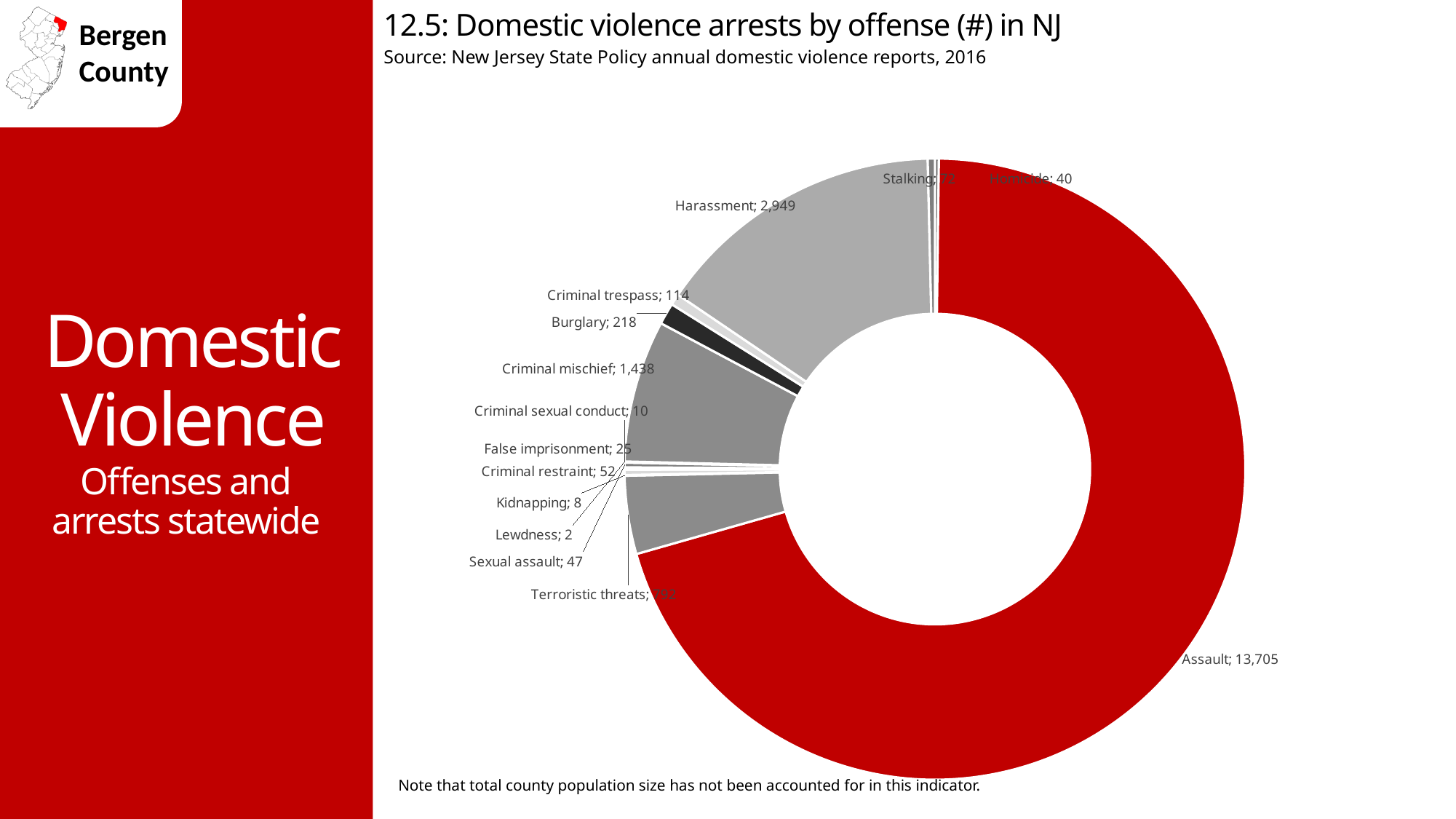
What is the value for Harassment? 2,949 How many offense categories are shown in the chart? 14 What is the difference between Burglary and Criminal trespass arrests? 104 What is the difference between Harassment and Criminal mischief arrests? 1,511 Which offense has the smallest number of arrests? Lewdness How many arrests for Assault are shown in the chart? 13,705 What type of chart is shown on the slide? Pie chart (donut) What is the value for Homicide? 40 Which is larger, Criminal restraint or False imprisonment? Criminal restraint What is the value for Burglary? 218 Which offense has the largest number of arrests? Assault What is the value for Criminal mischief? 1,438